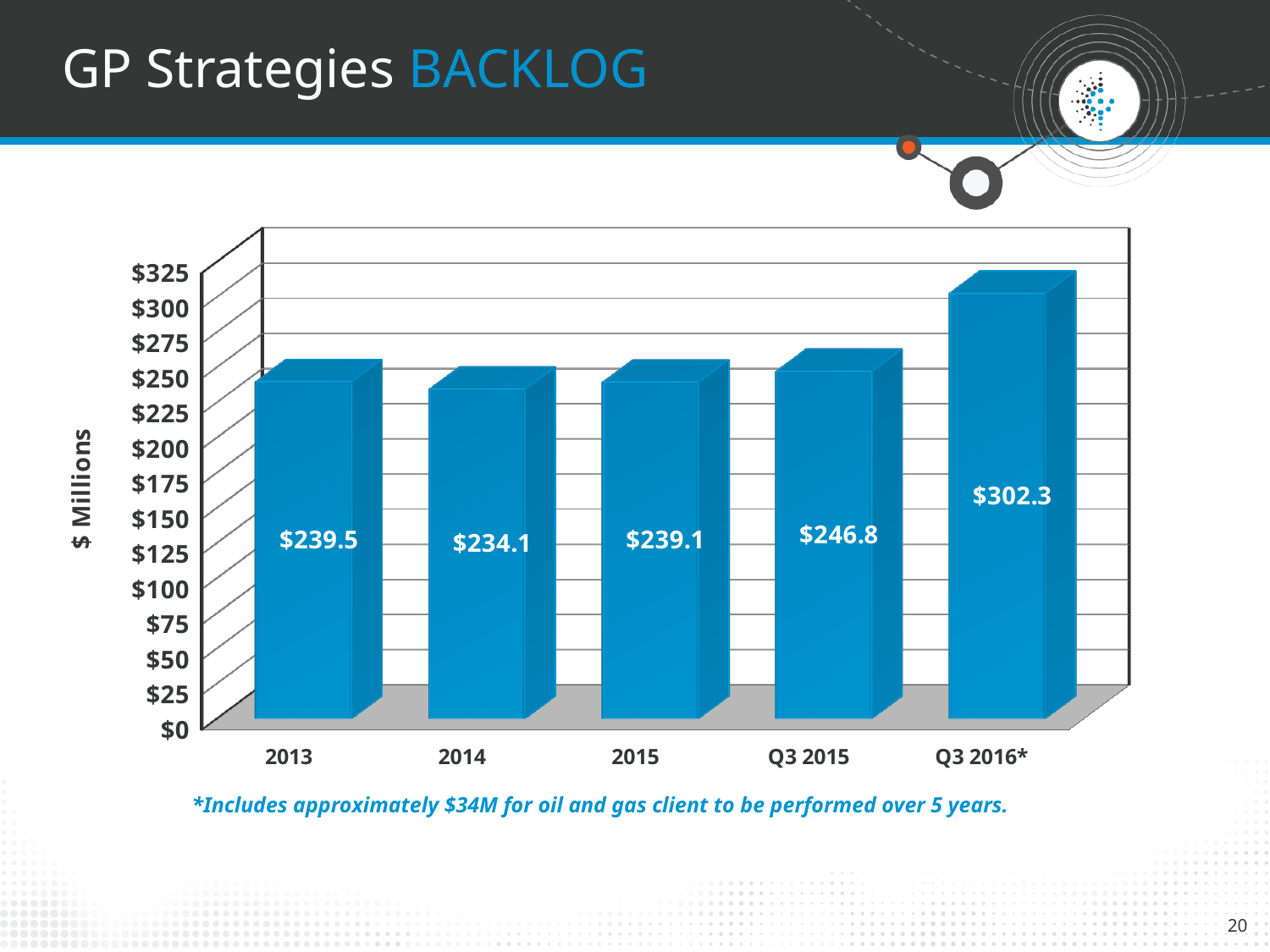
Is the value for Q3 2016* greater or less than $275? greater What is the difference between the backlog for Q3 2016* and Q3 2015? $55.5 How many categories are shown on the x axis? 5 What kind of chart is shown on the slide? bar chart What is the label of the y axis? $ Millions What is the backlog value for 2013? $239.5 Which category has the highest backlog? Q3 2016* Which is larger, the backlog for 2015 or for Q3 2015? Q3 2015 What is the backlog value for Q3 2016*? $302.3 What is the backlog value for 2014? $234.1 Which category has the lowest backlog? 2014 What is the difference between the backlog for 2013 and 2014? $5.4